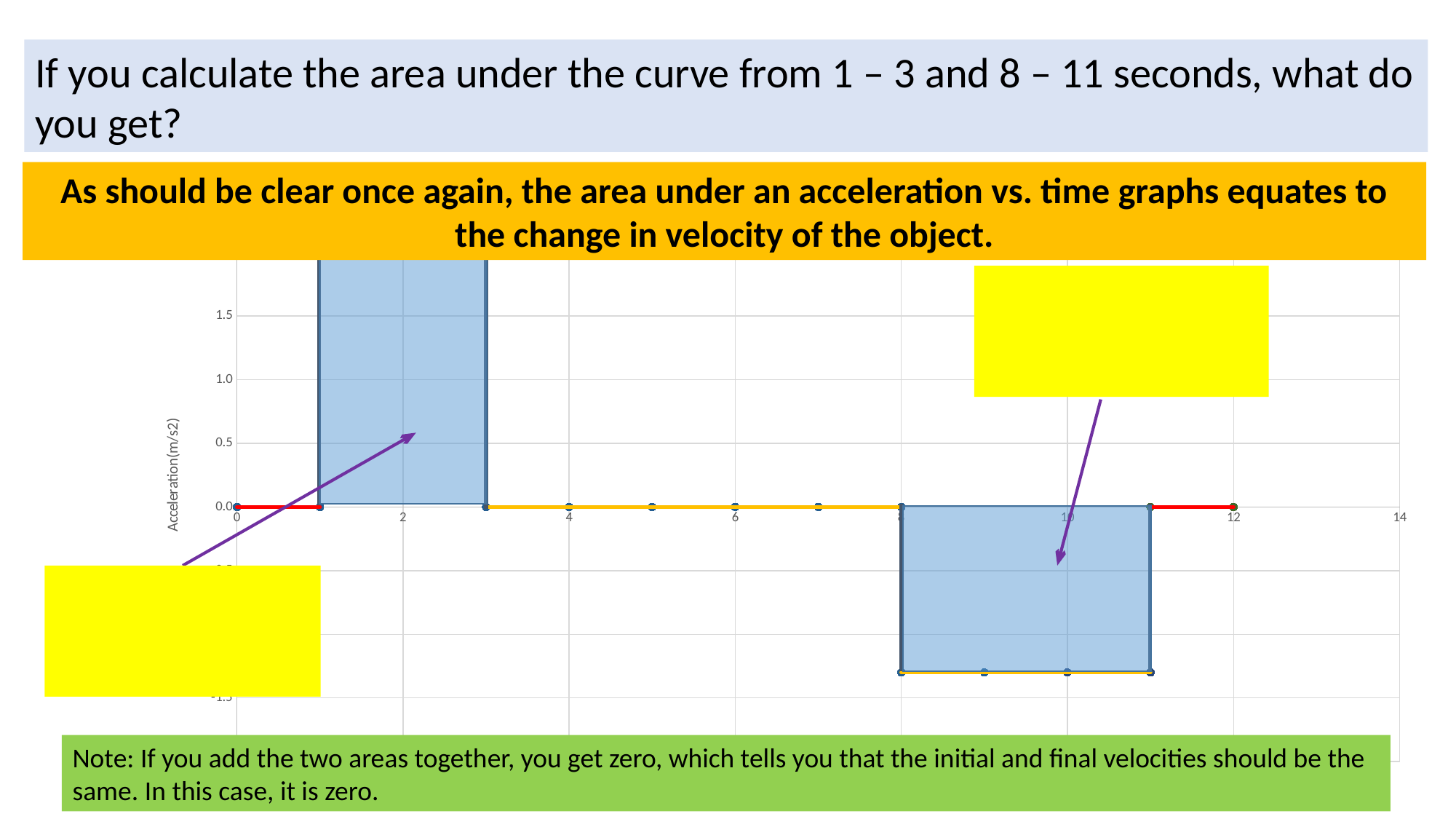
Is the acceleration value at 9 seconds greater or less than 0.0? less Is the acceleration between 1 and 3 seconds positive or negative? positive Is the acceleration value at 2 seconds greater or less than 1.0? greater Which is larger, the acceleration at 2 seconds or the acceleration at 9 seconds? 2 seconds What is the acceleration value at 5 seconds? 0.0 What kind of chart is shown on the slide? line chart Which is larger, the acceleration at 5 seconds or the acceleration at 10 seconds? 5 seconds What is the highest tick value shown on the horizontal axis of the chart? 14 Between 3 and 8 seconds, does the acceleration rise, fall, or stay flat? stay flat What is the label on the vertical axis of the chart? Acceleration(m/s2) What is the acceleration value at 12 seconds? 0.0